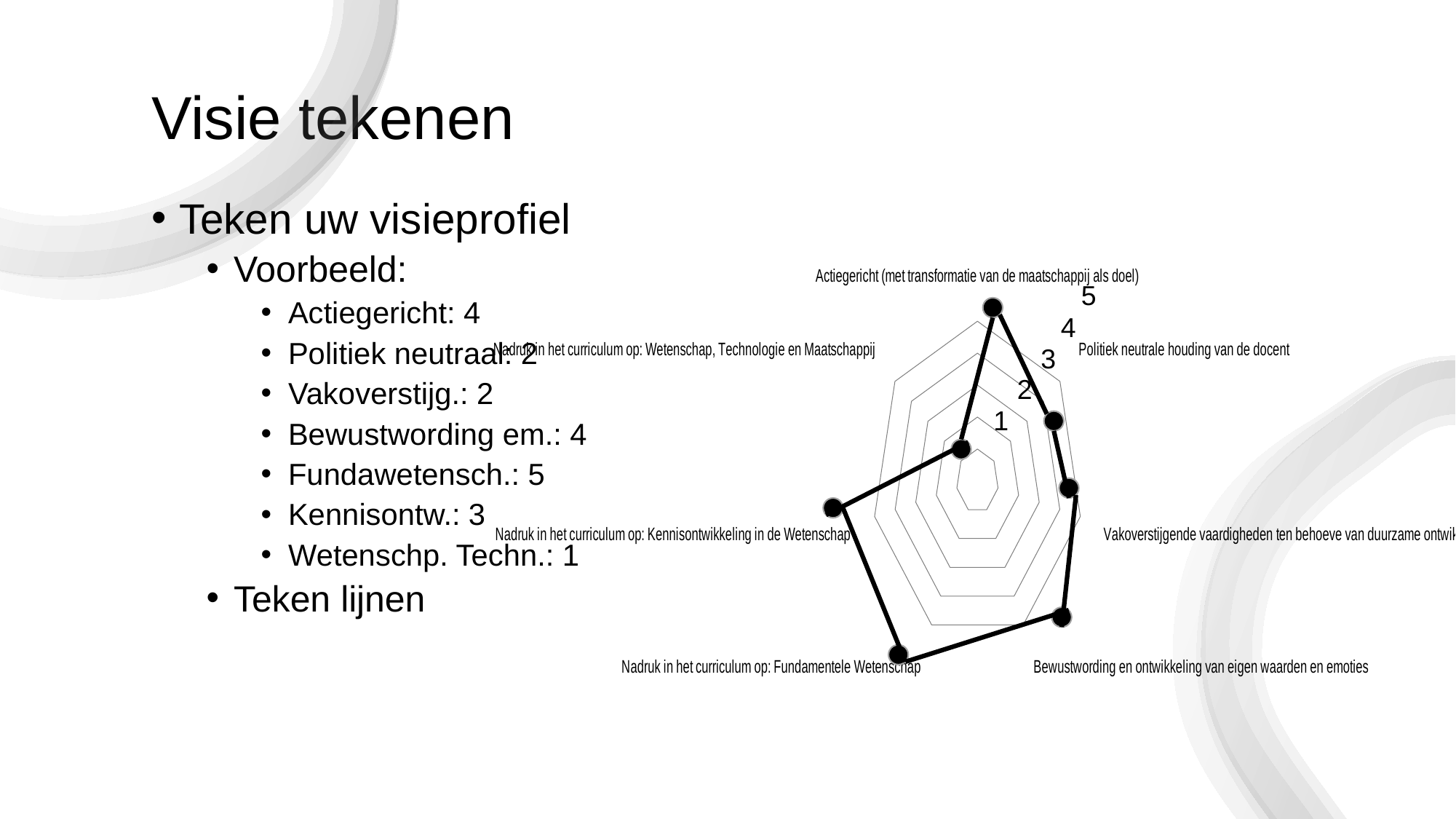
Which is larger: the value for 'Nadruk in het curriculum op: Fundamentele Wetenschap' or the value for 'Nadruk in het curriculum op: Wetenschap, Technologie en Maatschappij'? Nadruk in het curriculum op: Fundamentele Wetenschap Is the value for 'Nadruk in het curriculum op: Wetenschap, Technologie en Maatschappij' greater or less than 2? less How many categories (axes) does the radar chart have? 7 Which category is plotted at the top of the radar chart? Actiegericht (met transformatie van de maatschappij als doel) What is the highest value shown on the radar chart's scale? 5 Which category has the lowest value on the radar chart? Nadruk in het curriculum op: Wetenschap, Technologie en Maatschappij Is the value for 'Bewustwording en ontwikkeling van eigen waarden en emoties' greater or less than 3? greater Is the value for 'Nadruk in het curriculum op: Fundamentele Wetenschap' greater or less than 3? greater What kind of chart is shown on the slide? radar chart Which is larger: the value for 'Actiegericht (met transformatie van de maatschappij als doel)' or the value for 'Politiek neutrale houding van de docent'? Actiegericht (met transformatie van de maatschappij als doel)